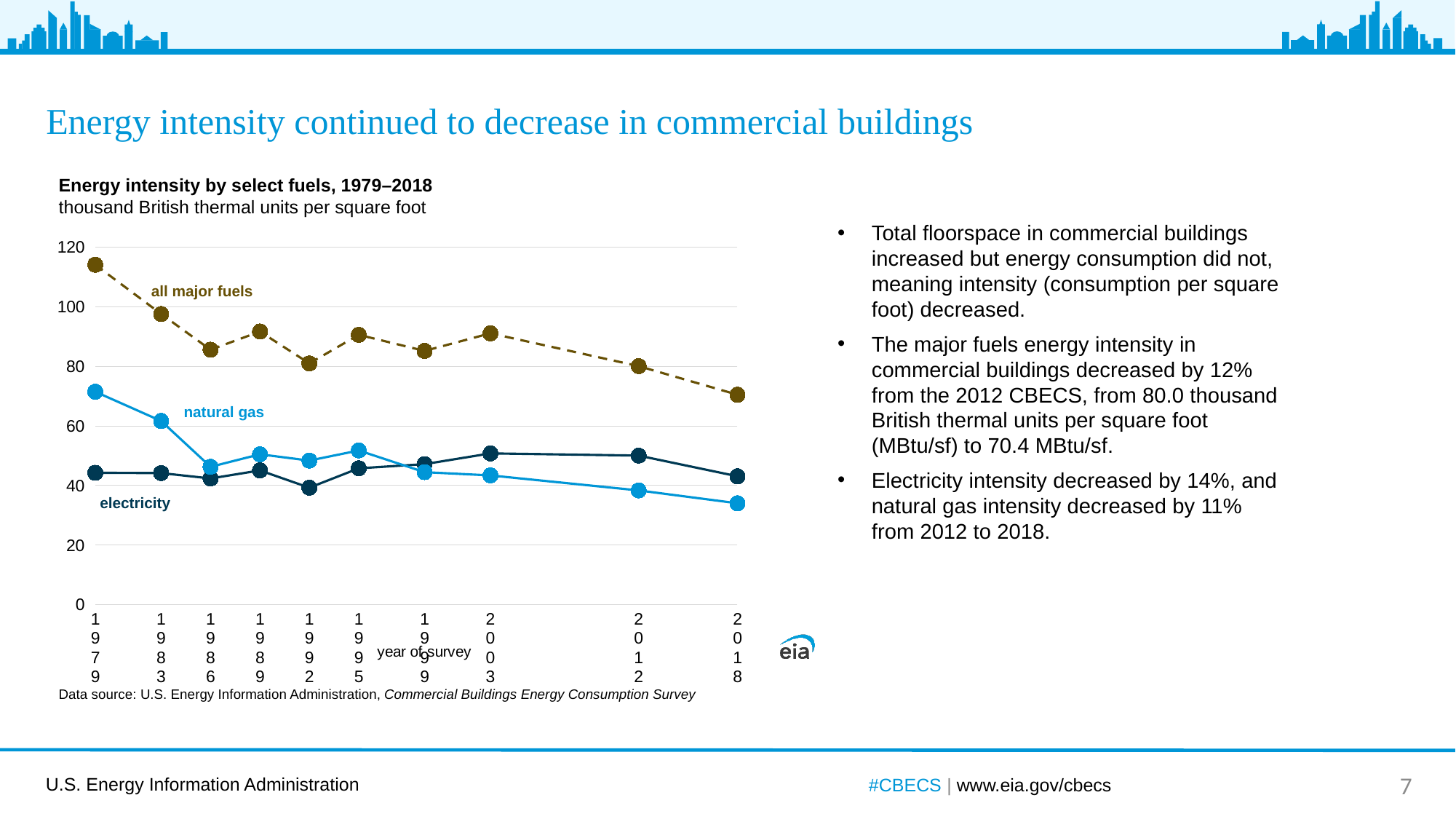
Is the value for all major fuels in 2018 greater or less than 80? less Is the value for all major fuels in 1979 greater or less than 100? greater In 1979, which is larger: natural gas or electricity energy intensity? natural gas In which survey year is the all major fuels energy intensity highest? 1979 Is the value for natural gas in 2018 greater or less than 40? less Does the all major fuels energy intensity rise or fall overall from 1979 to 2018? fall In which survey year is the all major fuels energy intensity lowest? 2018 What unit is the energy intensity measured in, according to the chart subtitle? thousand British thermal units per square foot What kind of chart is shown on the slide? line chart How many fuel series are plotted on the chart? 3 How many survey years are plotted along the x axis? 10